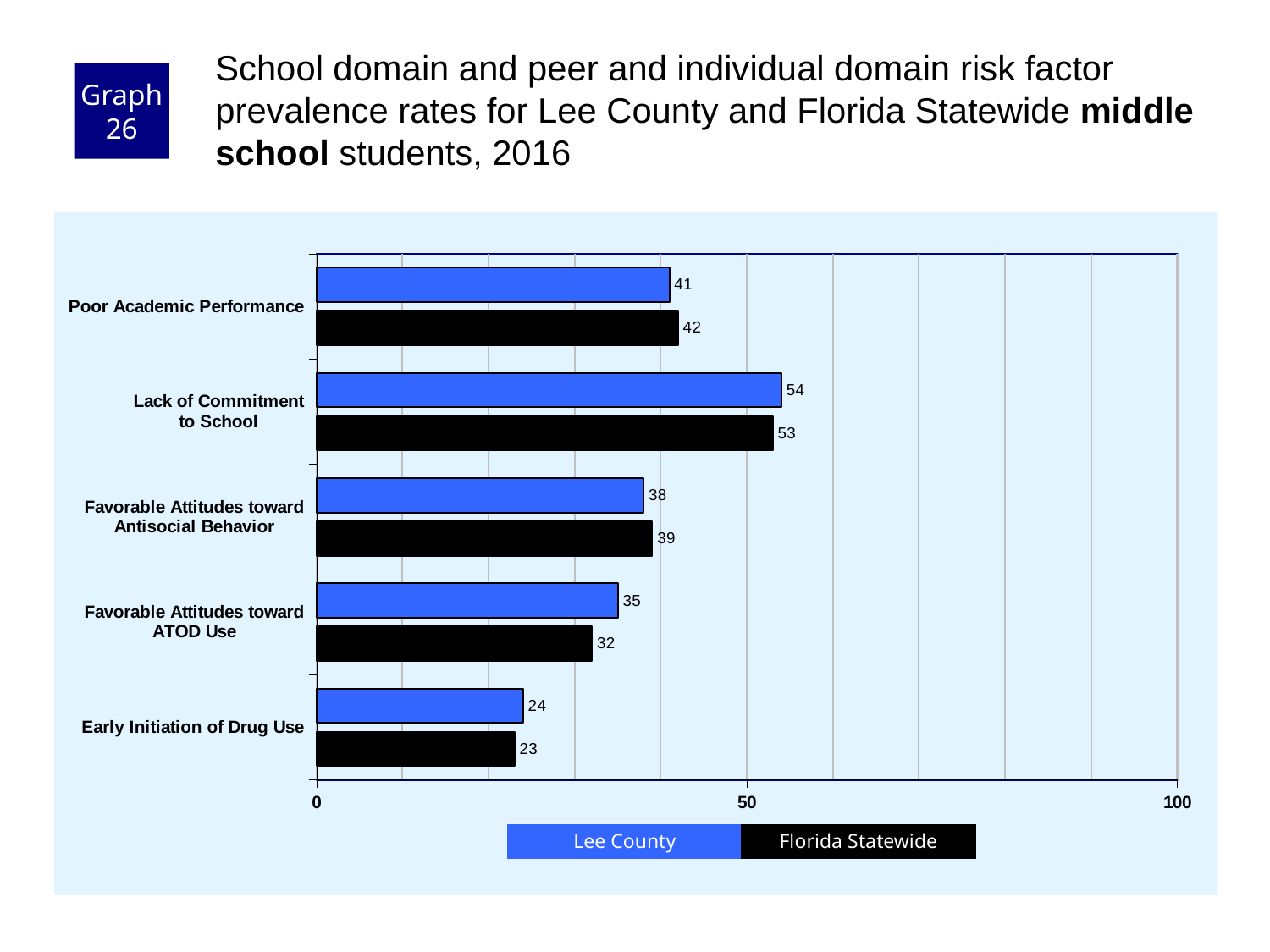
Which risk factor has the highest Lee County value? Lack of Commitment to School What is the Florida Statewide value for Favorable Attitudes toward ATOD Use? 32 What kind of chart is shown on the slide? bar chart Which is larger for Poor Academic Performance: the Lee County value or the Florida Statewide value? Florida Statewide What is the difference between the Lee County and Florida Statewide values for Favorable Attitudes toward ATOD Use? 3 What is the Lee County value for Lack of Commitment to School? 54 Which colour represents Florida Statewide in the chart? black What is the Lee County value for Early Initiation of Drug Use? 24 Is the Florida Statewide value for Lack of Commitment to School greater or less than 50? greater Which risk factor has the lowest Florida Statewide value? Early Initiation of Drug Use How many risk factor categories are shown on the chart? 5 How many series does the legend list? 2